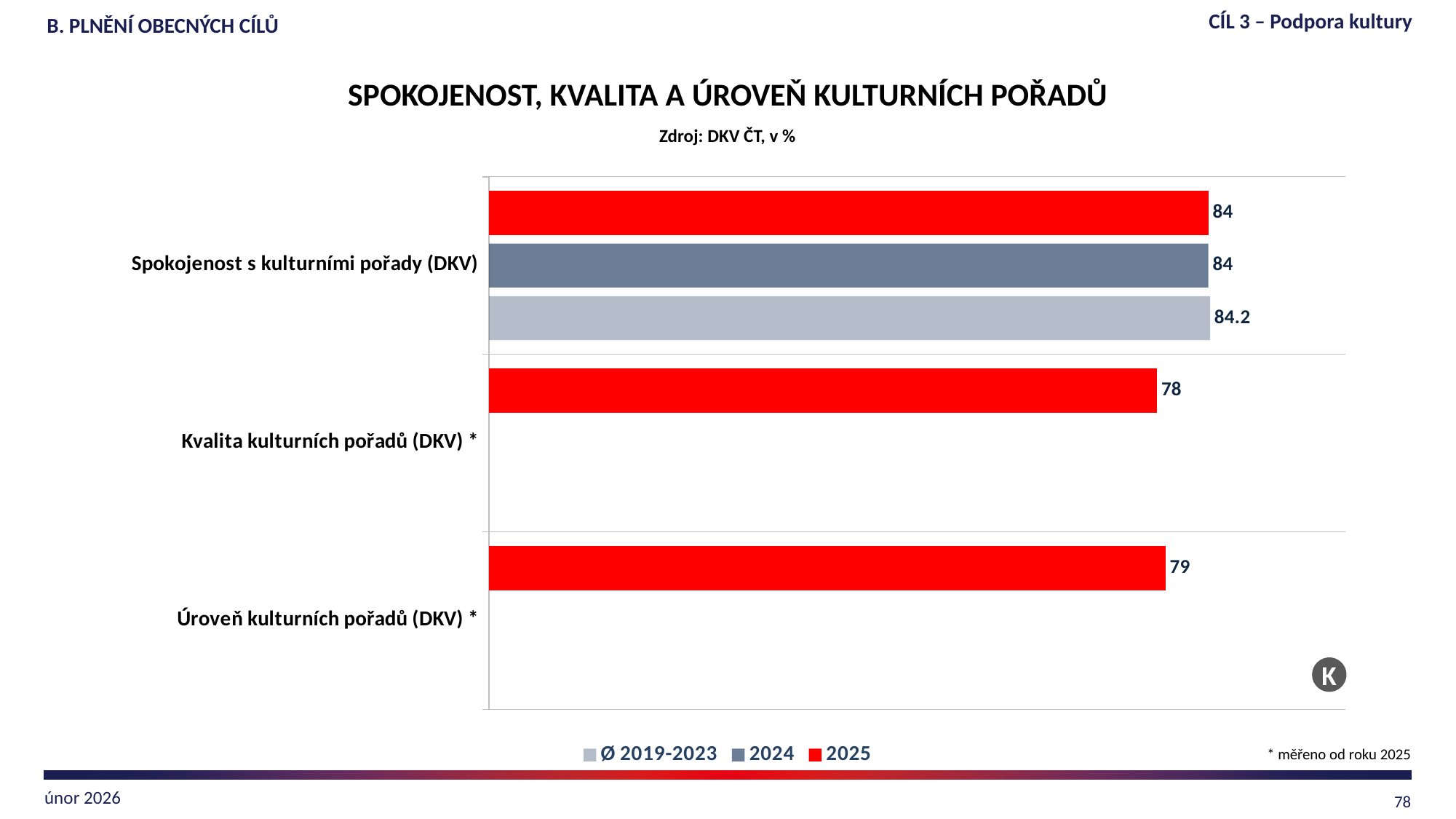
What is the difference between the 2025 values for Spokojenost s kulturními pořady (DKV) and Kvalita kulturních pořadů (DKV)? 6 How many series does the legend list? 3 Which category has the lowest 2025 value? Kvalita kulturních pořadů (DKV) What is the 2025 value for Spokojenost s kulturními pořady (DKV)? 84 What is the 2024 value for Spokojenost s kulturními pořady (DKV)? 84 Which category has the highest 2025 value? Spokojenost s kulturními pořady (DKV) What is the title of the chart? SPOKOJENOST, KVALITA A ÚROVEŇ KULTURNÍCH POŘADŮ What type of chart is shown on the slide? bar chart What is the Ø 2019-2023 value for Spokojenost s kulturními pořady (DKV)? 84.2 What is the 2025 value for Kvalita kulturních pořadů (DKV)? 78 Which is larger: the 2025 value for Úroveň kulturních pořadů (DKV) or the 2025 value for Kvalita kulturních pořadů (DKV)? Úroveň kulturních pořadů (DKV) What is the 2025 value for Úroveň kulturních pořadů (DKV)? 79